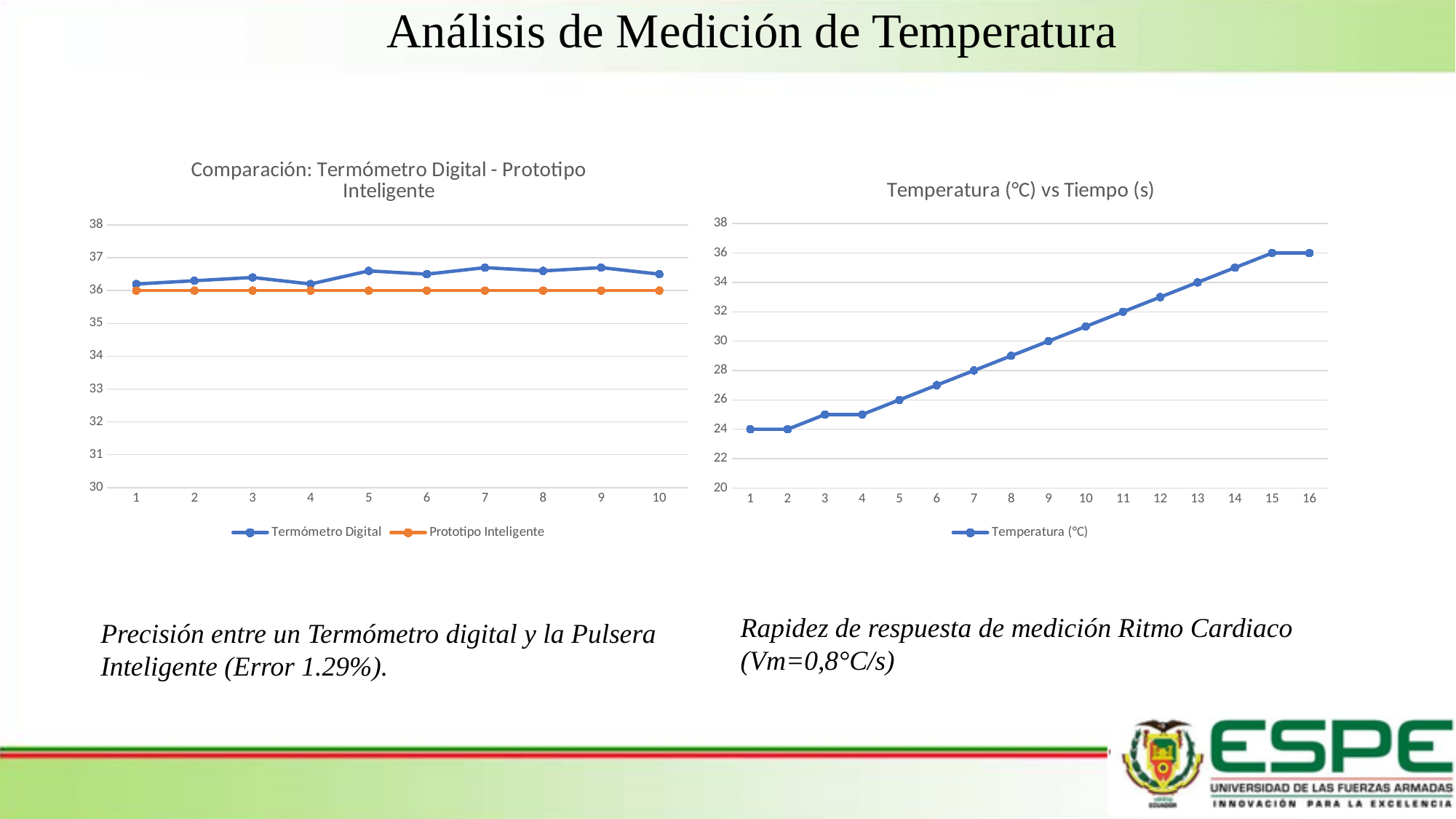
In the left chart 'Comparación: Termómetro Digital - Prototipo Inteligente', what is the value of Prototipo Inteligente at point 5? 36 In the left chart 'Comparación: Termómetro Digital - Prototipo Inteligente', which series has the higher value at point 9, Termómetro Digital or Prototipo Inteligente? Termómetro Digital In the right chart 'Temperatura (°C) vs Tiempo (s)', how many points are plotted? 16 How many series does the legend of the left chart 'Comparación: Termómetro Digital - Prototipo Inteligente' list? 2 In the right chart 'Temperatura (°C) vs Tiempo (s)', what is the difference between the temperature at time 16 and at time 2? 12 In the right chart 'Temperatura (°C) vs Tiempo (s)', what is the temperature at time 15? 36 What type of chart is the left chart titled 'Comparación: Termómetro Digital - Prototipo Inteligente'? line chart In the left chart 'Comparación: Termómetro Digital - Prototipo Inteligente', is the value of Termómetro Digital at point 7 greater or less than 36? greater In the left chart 'Comparación: Termómetro Digital - Prototipo Inteligente', how many points are plotted along the x axis for each series? 10 What is the title of the right chart? Temperatura (°C) vs Tiempo (s) In the left chart 'Comparación: Termómetro Digital - Prototipo Inteligente', what colour is the Prototipo Inteligente line? orange In the right chart 'Temperatura (°C) vs Tiempo (s)', what is the temperature at time 1? 24